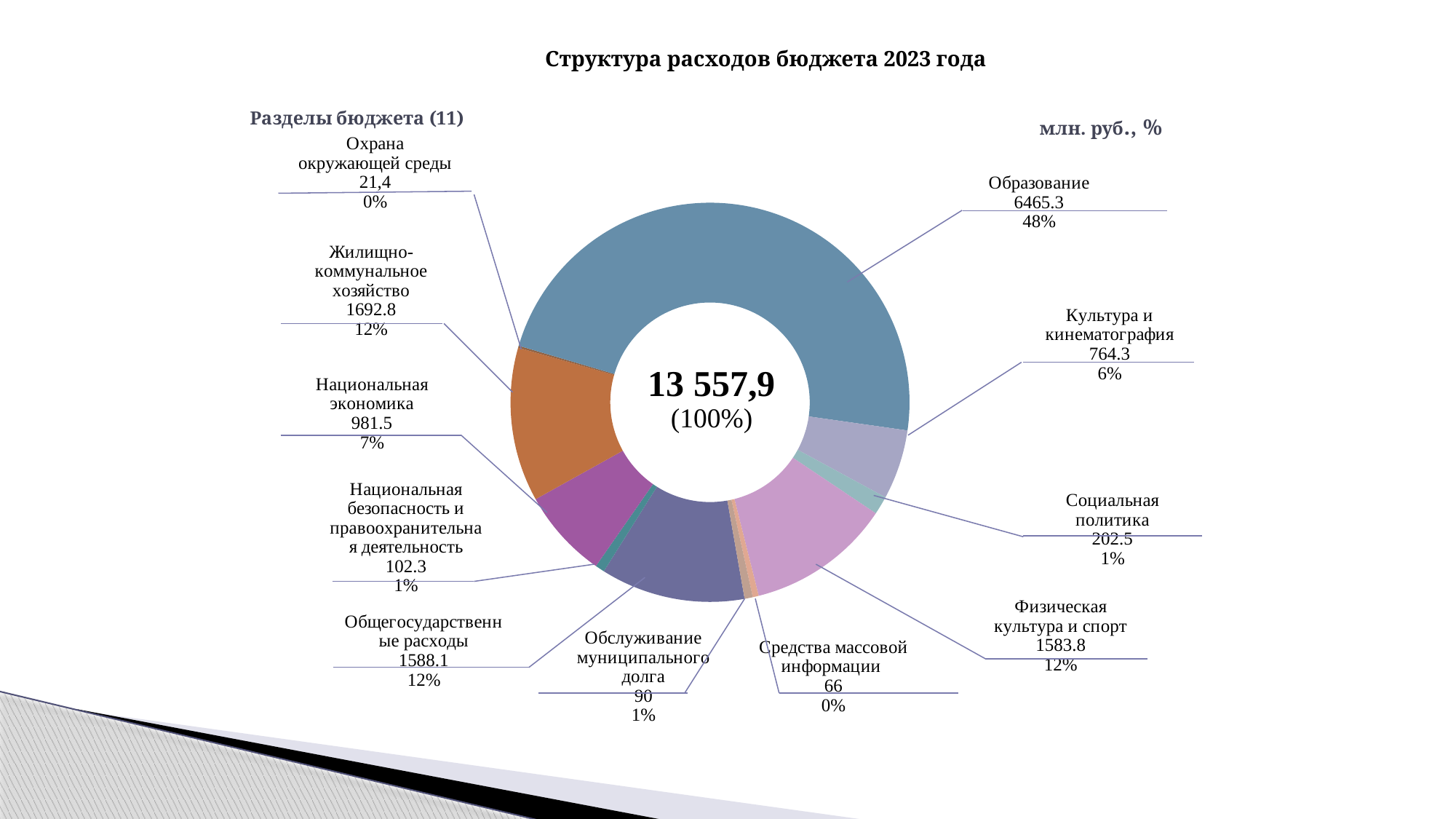
What is the total value shown in the centre of the chart? 13 557,9 Which budget section has the largest value? Образование What type of chart is shown on the slide? Pie (donut) chart Which budget section has the smallest value? Охрана окружающей среды What is the difference between the values for Общегосударственные расходы and Физическая культура и спорт? 4.3 What is the value shown for Образование? 6465.3 Which is larger: Национальная экономика or Культура и кинематография? Национальная экономика What is the value shown for Жилищно-коммунальное хозяйство? 1692.8 What share of the budget does Образование account for? 48% How many budget sections are shown in the chart? 11 What is the value shown for Охрана окружающей среды? 21,4 What is the title of the chart? Разделы бюджета (11)